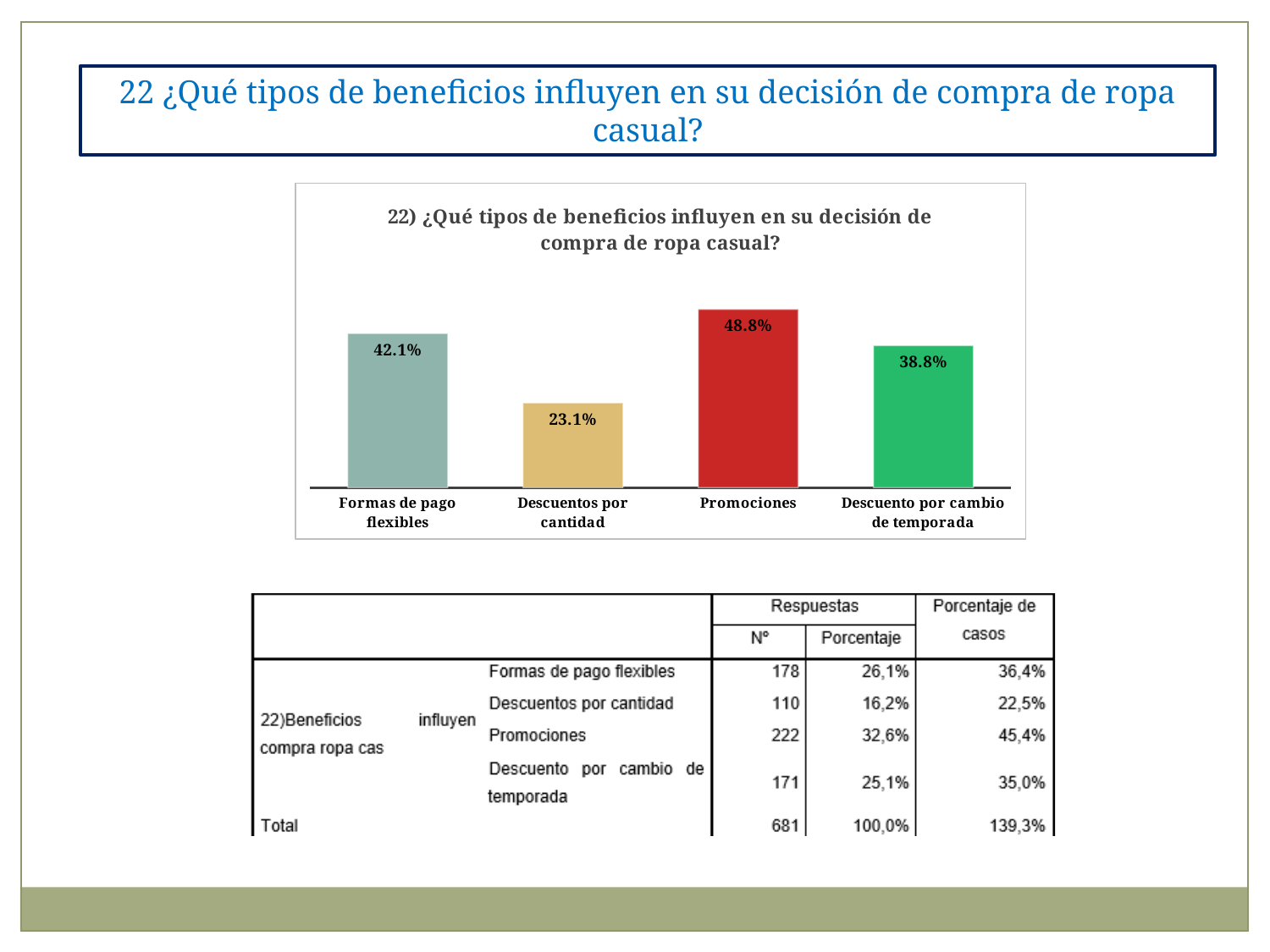
What is the value for Descuento por cambio de temporada? 38.8% What colour is the bar for Promociones? Red Which category has the highest value? Promociones Which category has the lowest value? Descuentos por cantidad Which is larger, the value for Formas de pago flexibles or the value for Descuento por cambio de temporada? Formas de pago flexibles What is the value for Formas de pago flexibles? 42.1% What kind of chart is shown on the slide? Bar chart What is the difference between the values for Formas de pago flexibles and Descuento por cambio de temporada? 3.3% How many categories are shown in the chart? 4 What is the value for Descuentos por cantidad? 23.1% What is the difference between the values for Promociones and Descuentos por cantidad? 25.7% What is the value for Promociones? 48.8%